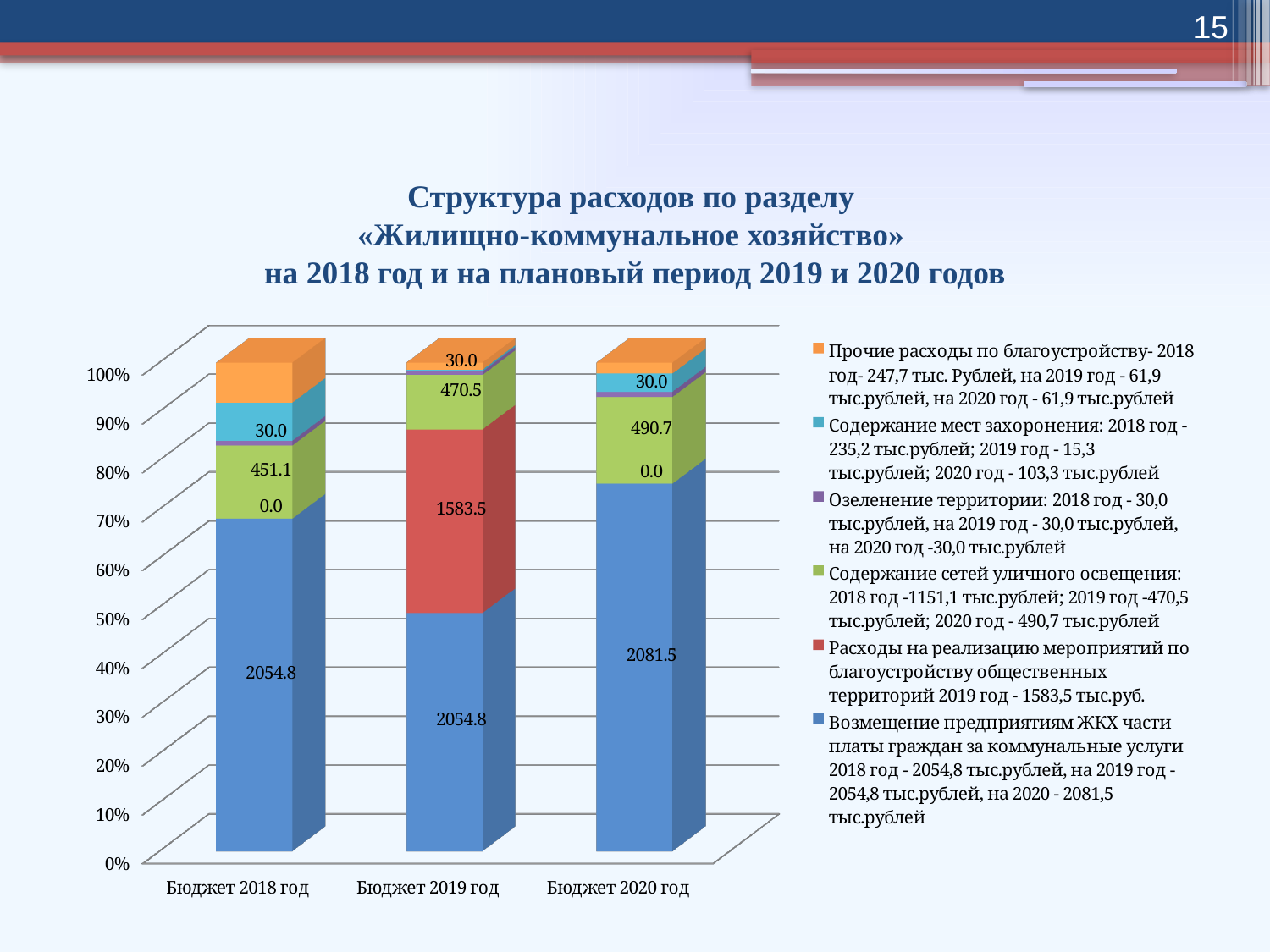
What kind of chart is shown on the slide? Stacked bar chart Is the share of the blue segment in the Бюджет 2019 год bar greater or less than 60%? less What is the value of the blue segment (Возмещение предприятиям ЖКХ) for Бюджет 2020 год? 2081.5 Which is larger: the blue segment value for Бюджет 2018 год or for Бюджет 2020 год? Бюджет 2020 год What is the value of the red segment for Бюджет 2018 год? 0.0 By how much does the green segment value for Бюджет 2020 год exceed that for Бюджет 2019 год? 20.2 Is the share of the blue segment in the Бюджет 2020 год bar greater or less than 70%? greater How many series does the chart legend list? 6 What is the value of the green segment (Содержание сетей уличного освещения) for Бюджет 2019 год? 470.5 What is the value of the red segment (Расходы на реализацию мероприятий по благоустройству) for Бюджет 2019 год? 1583.5 How many budget years (categories) are shown on the x axis of the chart? 3 What is the value of the green segment (Содержание сетей уличного освещения) for Бюджет 2020 год? 490.7